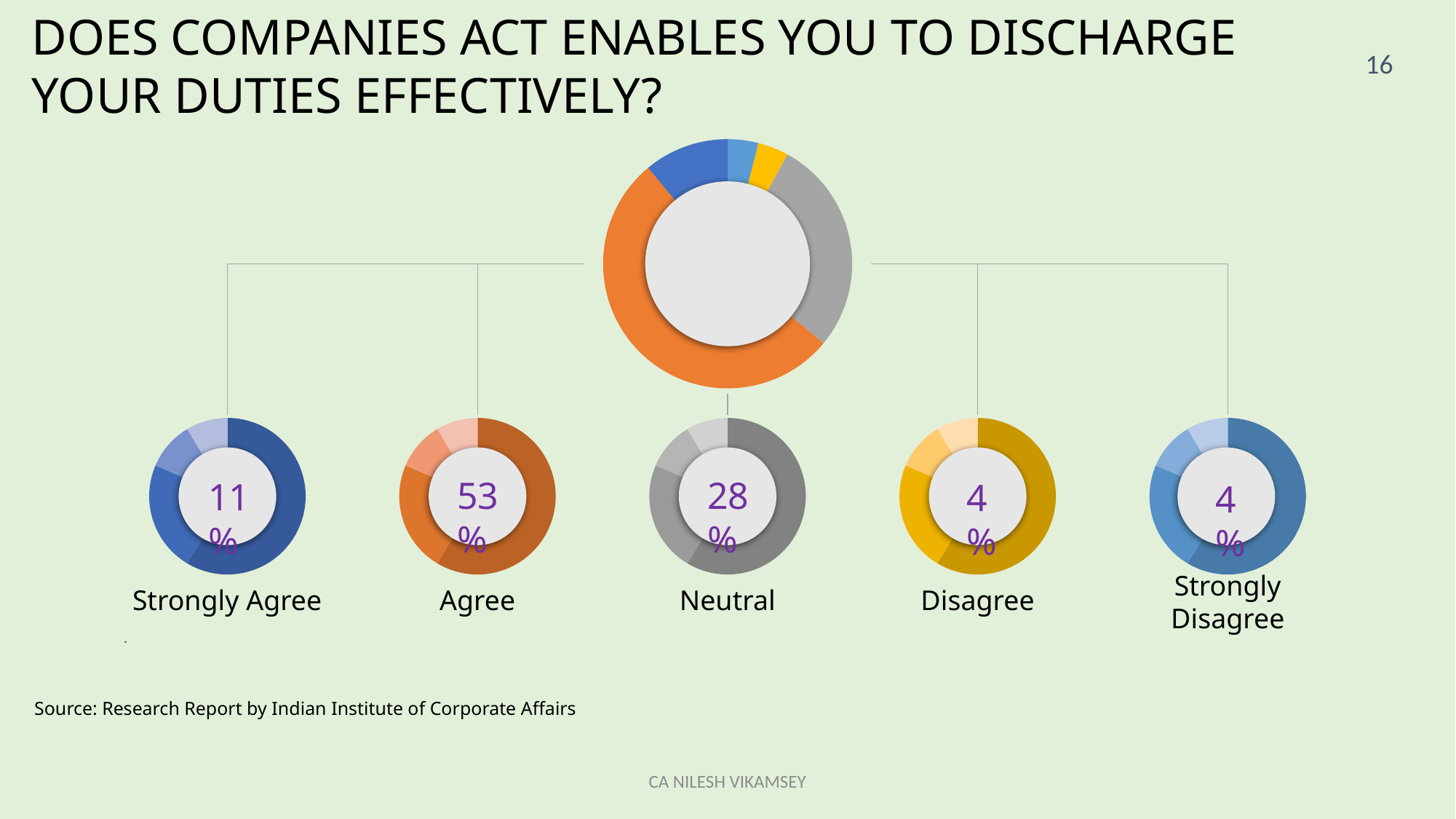
What is the difference in percentage points between Neutral and Strongly Agree? 17 Which response category has the highest percentage? Agree What kind of chart is the large chart in the centre of the slide? Doughnut chart How many response categories are shown on the slide? 5 Which is larger, the percentage for Strongly Agree or the percentage for Neutral? Neutral What is the difference in percentage points between Agree and Neutral? 25 What percentage of respondents chose Agree? 53% What percentage of respondents chose Neutral? 28% What is the combined percentage of Strongly Agree and Agree? 64% What percentage of respondents chose Strongly Agree? 11% What percentage of respondents chose Disagree? 4% Which colour represents Neutral in the large central doughnut chart? Grey